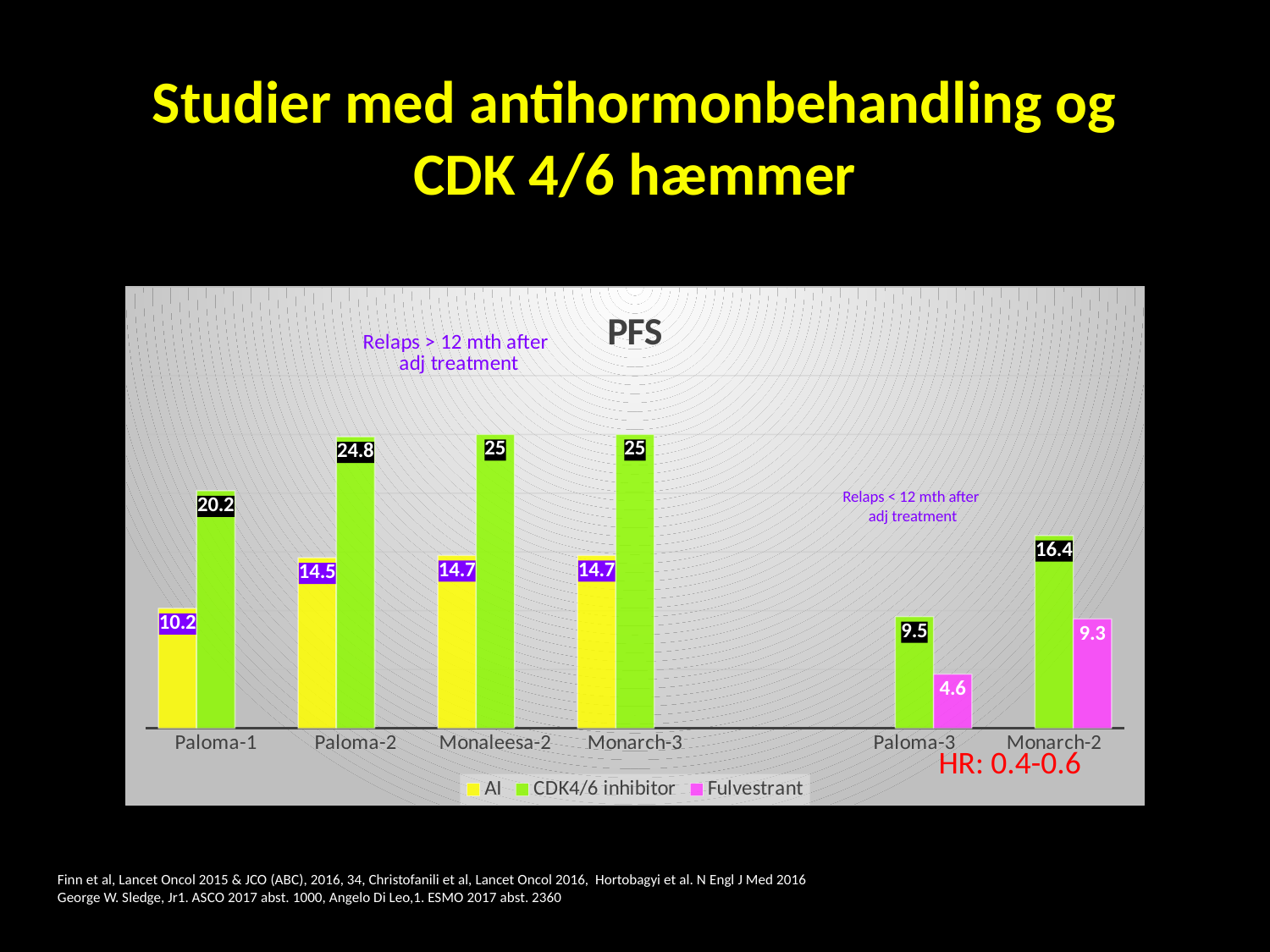
Which study has the lowest CDK4/6 inhibitor value? Paloma-3 What is the value of the CDK4/6 inhibitor bar for Monarch-2? 16.4 What is the title of the chart? PFS How many series does the legend list? 3 What is the value of the Fulvestrant bar for Paloma-3? 4.6 Which is larger, the AI value for Paloma-2 or the AI value for Monaleesa-2? Monaleesa-2 What type of chart is shown on the slide? Bar chart What is the PFS value for the CDK4/6 inhibitor bar in Paloma-2? 24.8 Which study has the lowest AI value? Paloma-1 What is the difference between the CDK4/6 inhibitor and Fulvestrant values in Monarch-2? 7.1 What is the value of the AI bar for Paloma-1? 10.2 What is the difference between the CDK4/6 inhibitor and AI values in Paloma-1? 10